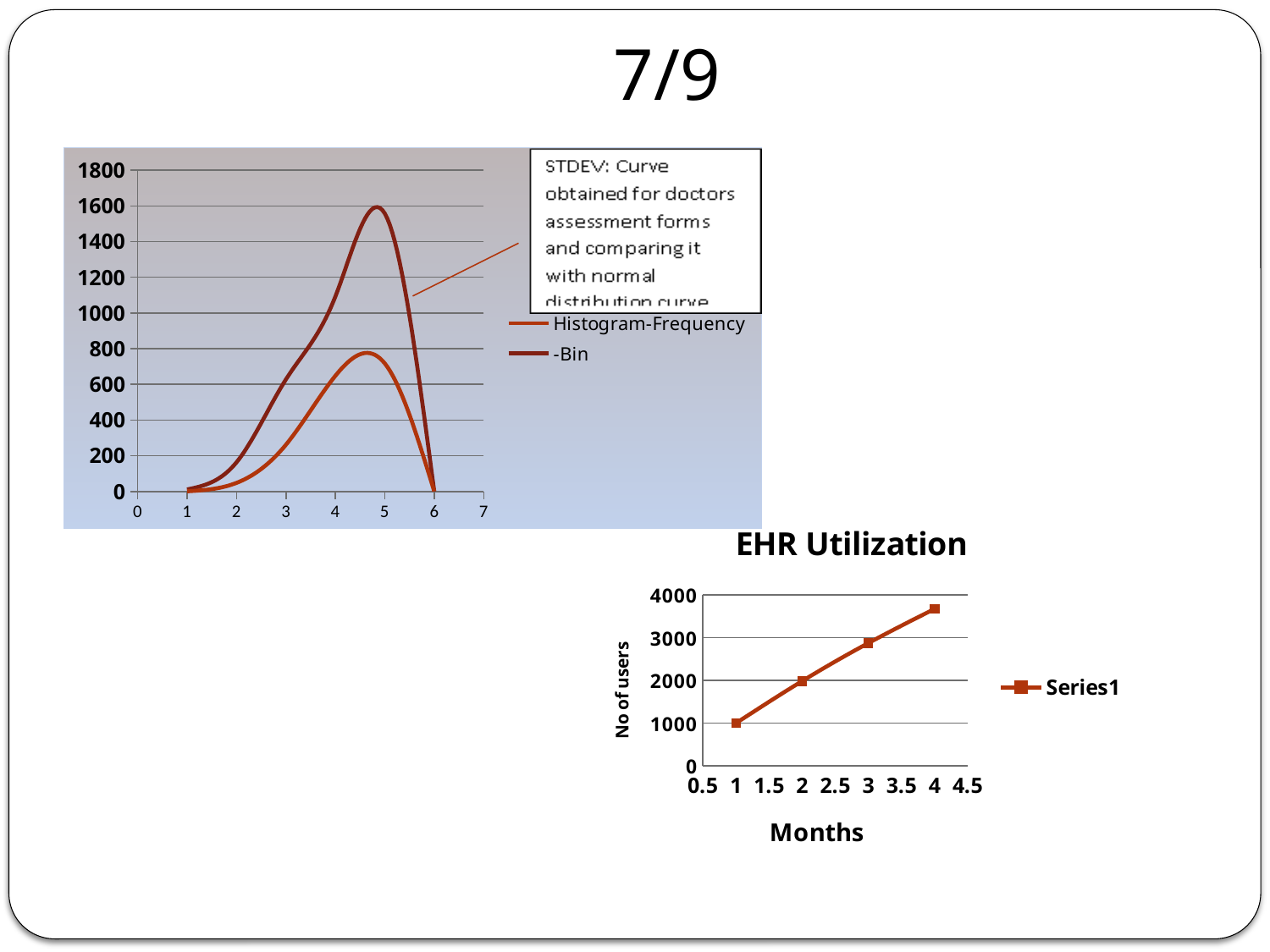
In the EHR Utilization chart, which month has the lowest number of users? 1 In the EHR Utilization chart, how many data points are plotted? 4 In the top-left chart, which series reaches the higher peak, Histogram-Frequency or -Bin? -Bin How many series does the legend of the EHR Utilization chart list? 1 In the EHR Utilization chart, is the number of users at month 4 greater or less than 3000? greater In the EHR Utilization chart, do the values rise or fall as the months increase? rise What kind of chart is the EHR Utilization chart? line chart How many series does the legend of the top-left chart list? 2 In the EHR Utilization chart, is the number of users at month 3 greater or less than 2000? greater In the top-left chart, is the peak value of the Histogram-Frequency series greater or less than 1000? less In the EHR Utilization chart, which month has the highest number of users? 4 What is the y-axis title of the EHR Utilization chart? No of users